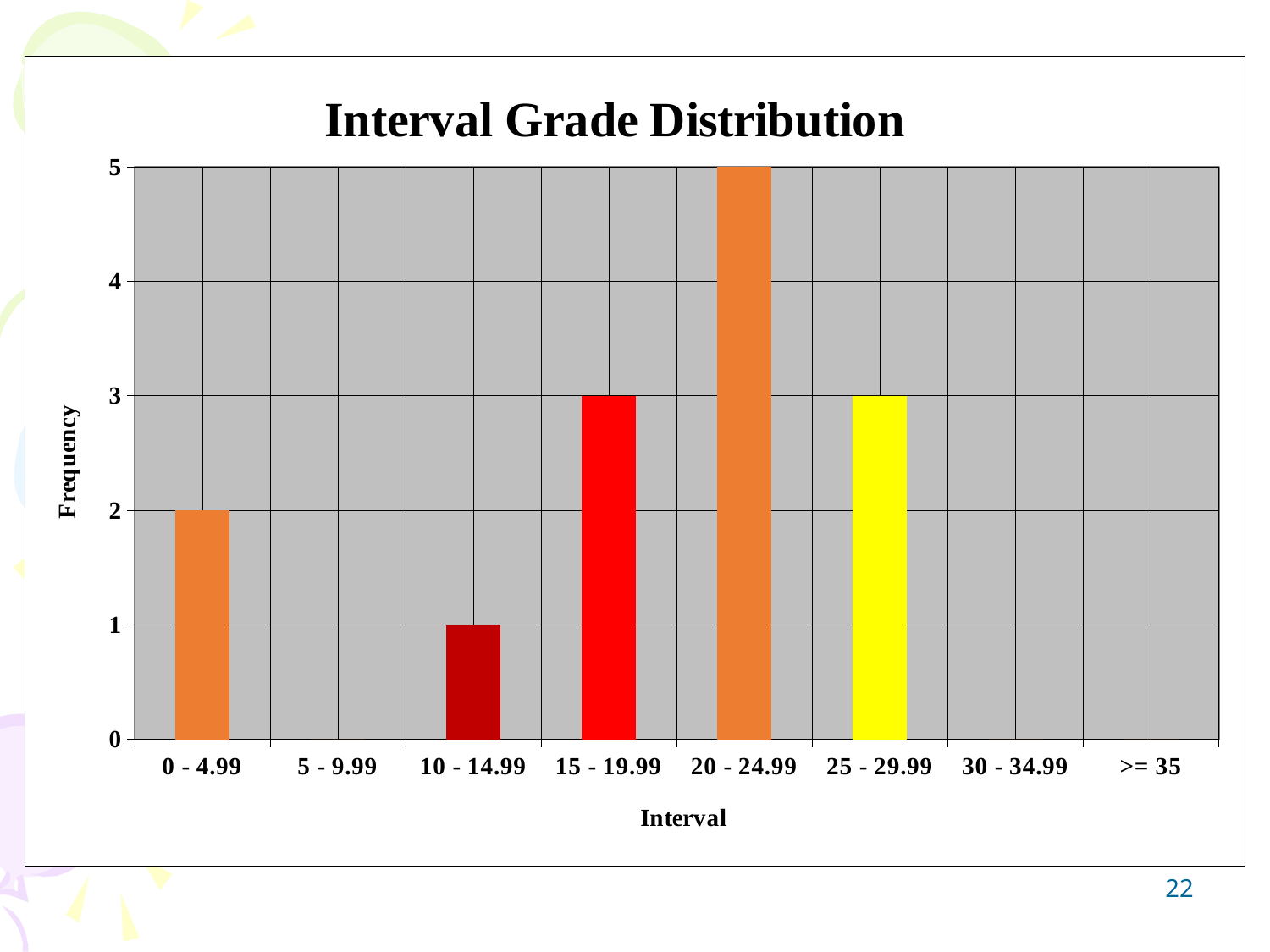
What is the frequency for the 15 - 19.99 interval? 3 What is the frequency for the 20 - 24.99 interval? 5 What is the title of the chart? Interval Grade Distribution What is the frequency for the 0 - 4.99 interval? 2 Which interval has the highest frequency? 20 - 24.99 What is the label of the y axis? Frequency What type of chart is shown on the slide? Bar chart What is the difference in frequency between the 20 - 24.99 interval and the 25 - 29.99 interval? 2 Is the frequency for the 20 - 24.99 interval greater or less than 4? greater How many intervals are shown on the x axis? 8 Which has a higher frequency, the 0 - 4.99 interval or the 15 - 19.99 interval? 15 - 19.99 What is the frequency for the 10 - 14.99 interval? 1